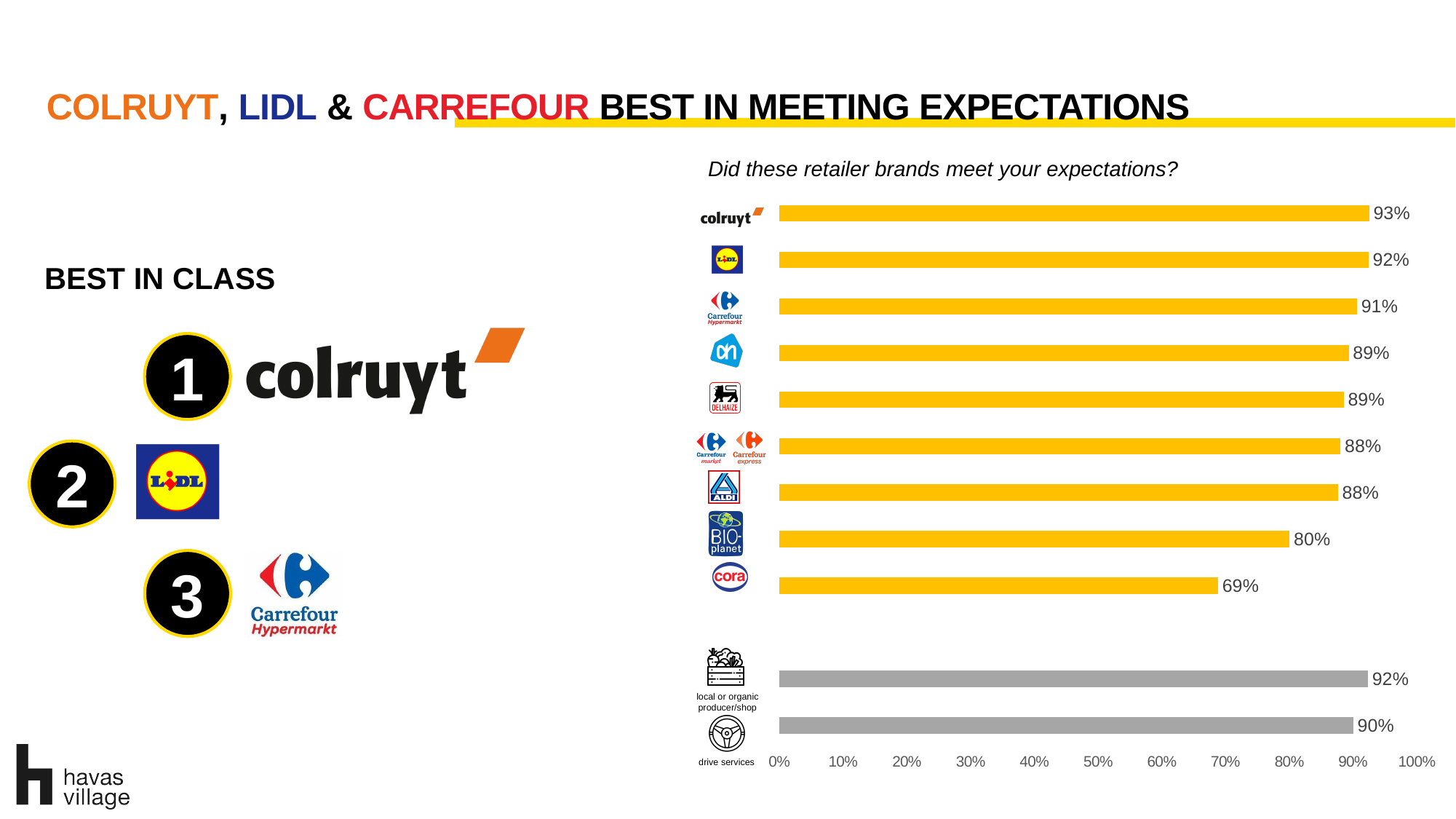
How many bars are plotted in the chart? 11 What question is shown as the chart's title? Did these retailer brands meet your expectations? What value is shown for local or organic producer/shop? 92% Which retailer brand has the lowest value in the chart? Cora What type of chart is shown on the slide? Bar chart What percentage of respondents said Colruyt met their expectations? 93% Which retailer brand has the highest value in the chart? Colruyt What value is shown for Bio-planet? 80% What value is shown for drive services? 90% What is the value shown for Cora in the chart? 69% What is the difference between the values for Colruyt and Cora? 24 percentage points Which has a higher value, Lidl or Aldi? Lidl